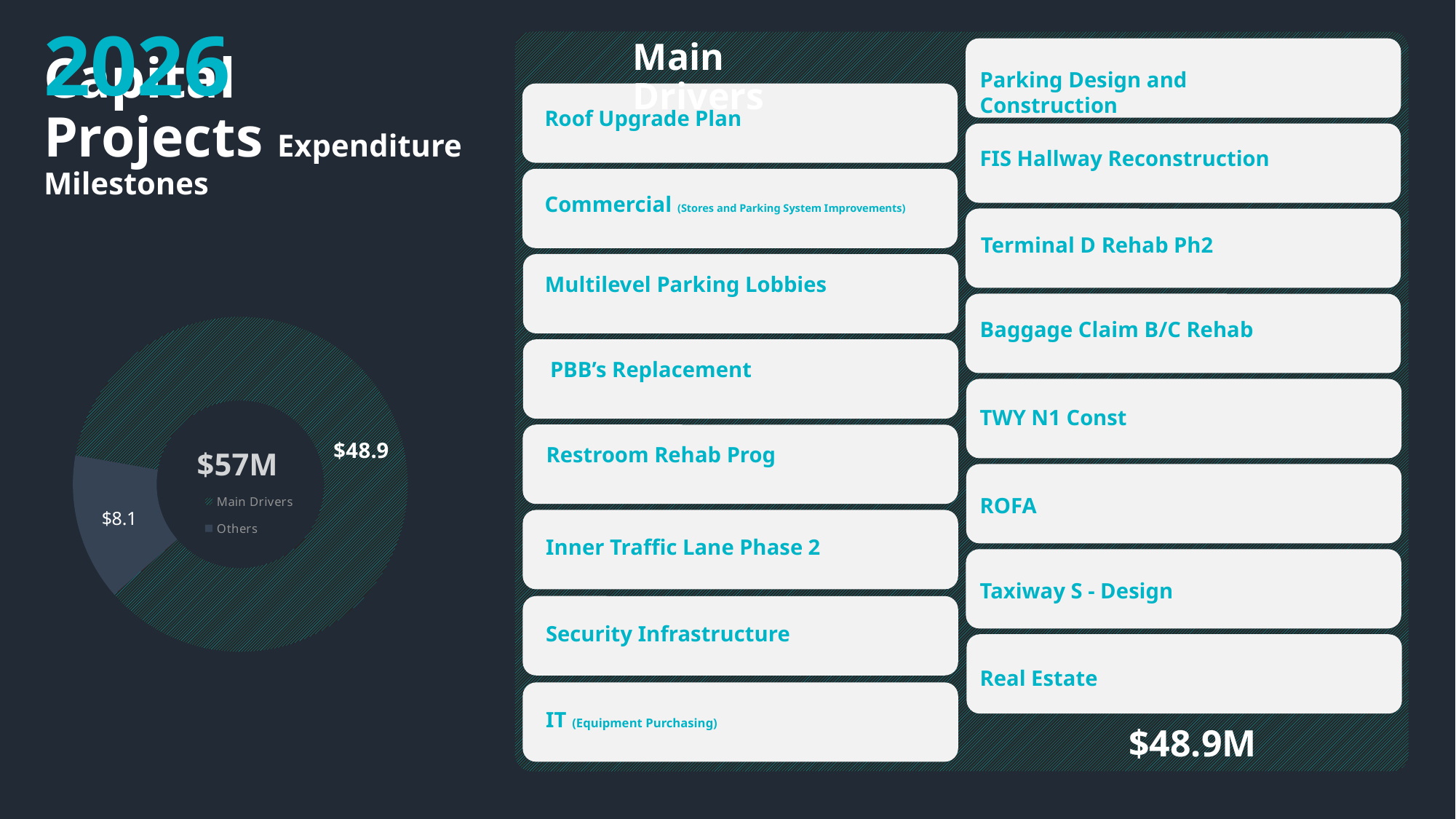
What total value is printed in the center of the donut chart? $57M What is the difference between the Main Drivers value and the Others value in the donut chart? $40.8 Which slice of the donut chart is the smallest? Others How many entries does the legend of the donut chart list? 2 How many slices does the donut chart have? 2 What is the value shown for the Main Drivers slice of the donut chart? $48.9 What is the value shown for the Others slice of the donut chart? $8.1 What total is printed at the bottom of the Main Drivers panel on the right of the slide? $48.9M What are the two legend entries of the donut chart? Main Drivers and Others Which slice of the donut chart is the largest? Main Drivers In the donut chart, which is larger: Main Drivers or Others? Main Drivers What kind of chart is shown on the left of the slide? Donut (pie) chart